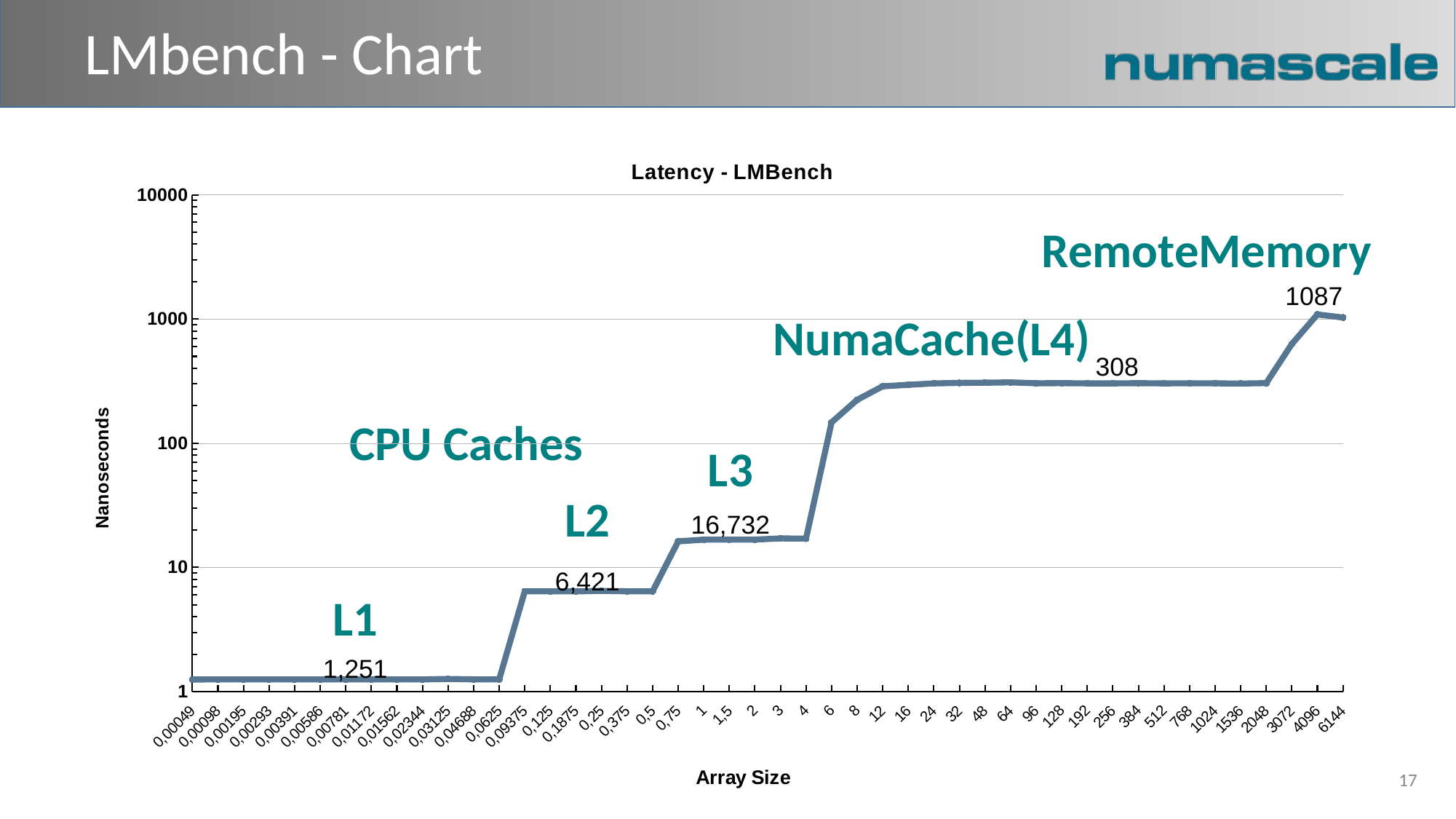
What latency value is labelled for the L1 cache plateau? 1,251 Which labelled region has the highest latency value? RemoteMemory What latency value is labelled for the L3 cache plateau? 16,732 What latency value is labelled for the NumaCache(L4) plateau? 308 What kind of chart is shown on the slide? line chart What is the title of the chart? Latency - LMBench What is the difference between the RemoteMemory latency (1087) and the NumaCache(L4) latency (308)? 779 Is the latency at array size 64 greater or less than 100 nanoseconds? greater Which labelled region has the lowest latency value? L1 What is the label of the y axis? Nanoseconds What latency value is labelled for the L2 cache plateau? 6,421 What latency value is labelled for RemoteMemory? 1087